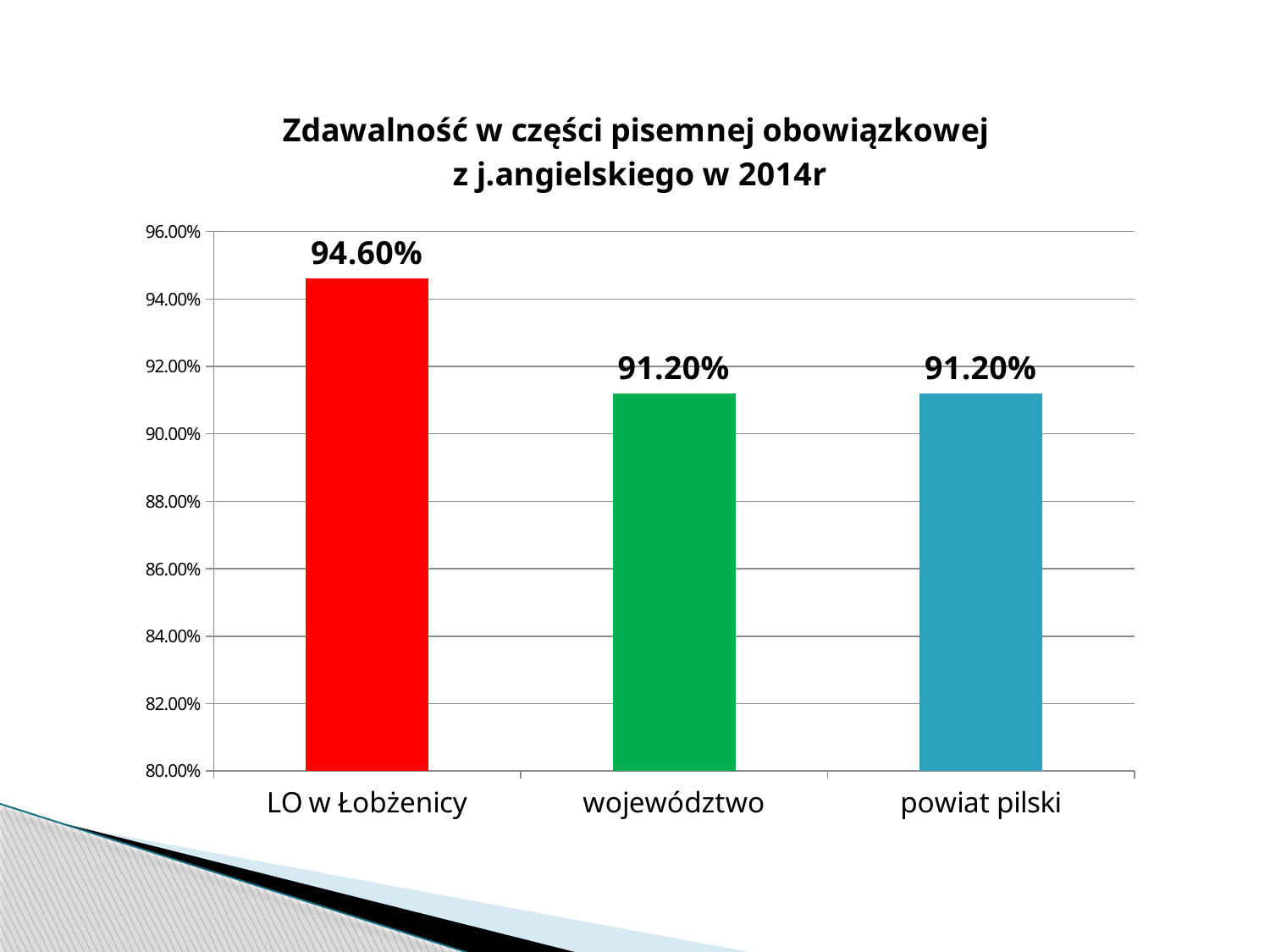
Which category has the highest value? LO w Łobżenicy What is the value for województwo? 91.20% What is the value for powiat pilski? 91.20% How many categories are shown on the chart? 3 What colour is the bar for LO w Łobżenicy? red What is the title of the chart? Zdawalność w części pisemnej obowiązkowej z j.angielskiego w 2014r What is the difference between the values for LO w Łobżenicy and województwo? 3.40% Is the value for LO w Łobżenicy greater or less than 94.00%? greater Which is larger, the value for LO w Łobżenicy or the value for powiat pilski? LO w Łobżenicy What kind of chart is shown on the slide? bar chart Is the value for województwo greater or less than 92.00%? less What is the value for LO w Łobżenicy? 94.60%